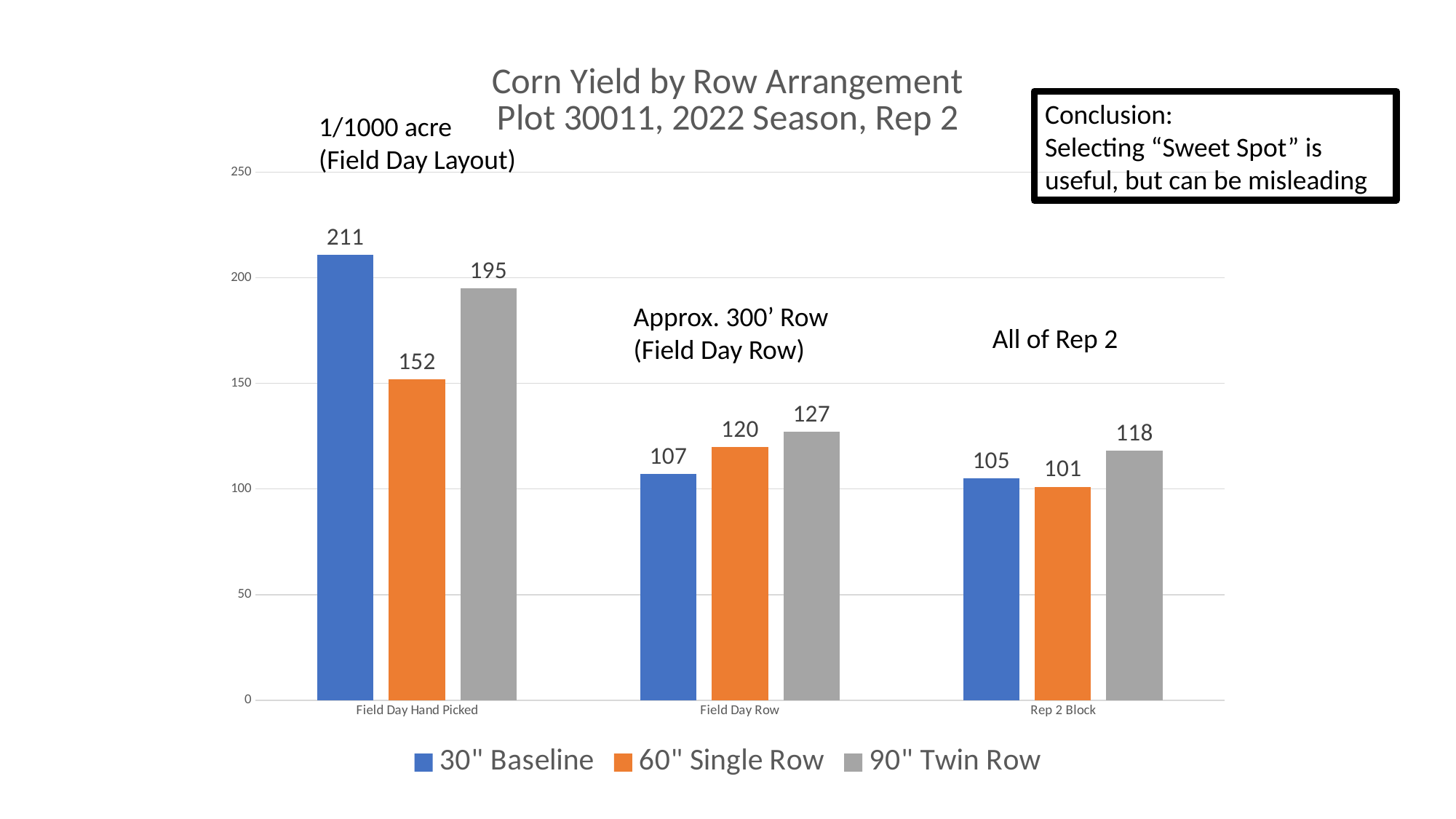
What kind of chart is shown on the slide? Bar chart How many categories are shown on the x axis? 3 What is the value for 90" Twin Row in the Rep 2 Block category? 118 What is the difference between the 90" Twin Row and 30" Baseline values in the Field Day Row category? 20 Which series has the highest value in the Field Day Hand Picked category? 30" Baseline What is the difference between the 30" Baseline and 60" Single Row values in the Field Day Hand Picked category? 59 Which series has the lowest value in the Rep 2 Block category? 60" Single Row Which is larger in the Rep 2 Block category: 30" Baseline or 90" Twin Row? 90" Twin Row Is the value for 60" Single Row in the Field Day Hand Picked category greater or less than 150? greater How many series does the legend list? 3 What is the value for 60" Single Row in the Field Day Row category? 120 What is the value for 30" Baseline in the Field Day Hand Picked category? 211